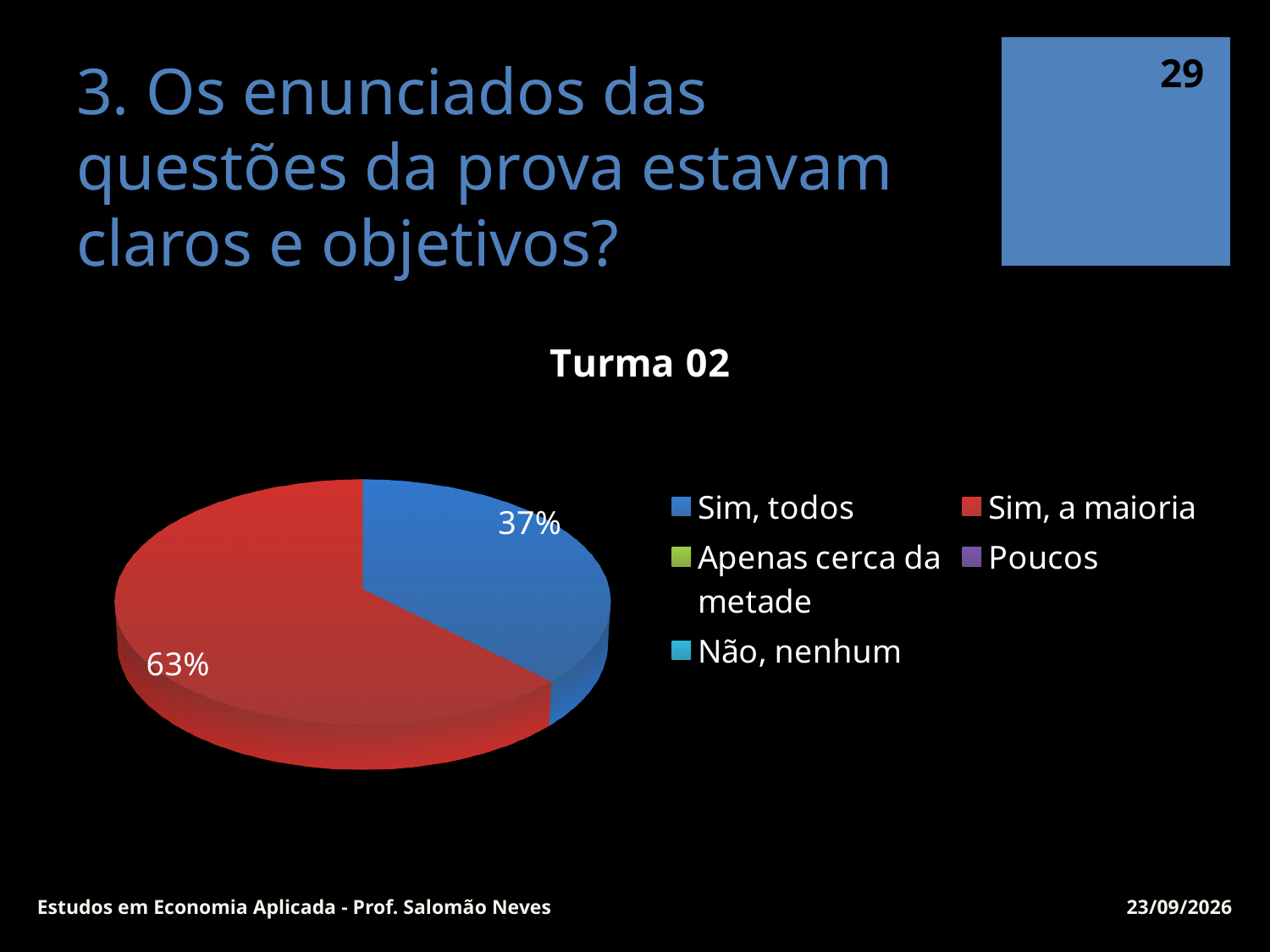
What share of the pie does "Sim, todos" represent? 37% How many slices with data labels are visible in the pie? 2 How many entries does the legend list? 5 Which category has the largest slice of the pie? Sim, a maioria What is the difference in percentage points between the "Sim, a maioria" slice and the "Sim, todos" slice? 26 What kind of chart is shown on the slide? pie chart What share of the pie does "Sim, a maioria" represent? 63% What is the title of the chart? Turma 02 Which of the two labelled slices is smaller, "Sim, todos" or "Sim, a maioria"? Sim, todos Is the share for "Sim, a maioria" greater or less than 50%? greater What is the combined share of the "Sim, todos" and "Sim, a maioria" slices? 100% What colour is the "Sim, a maioria" slice? red